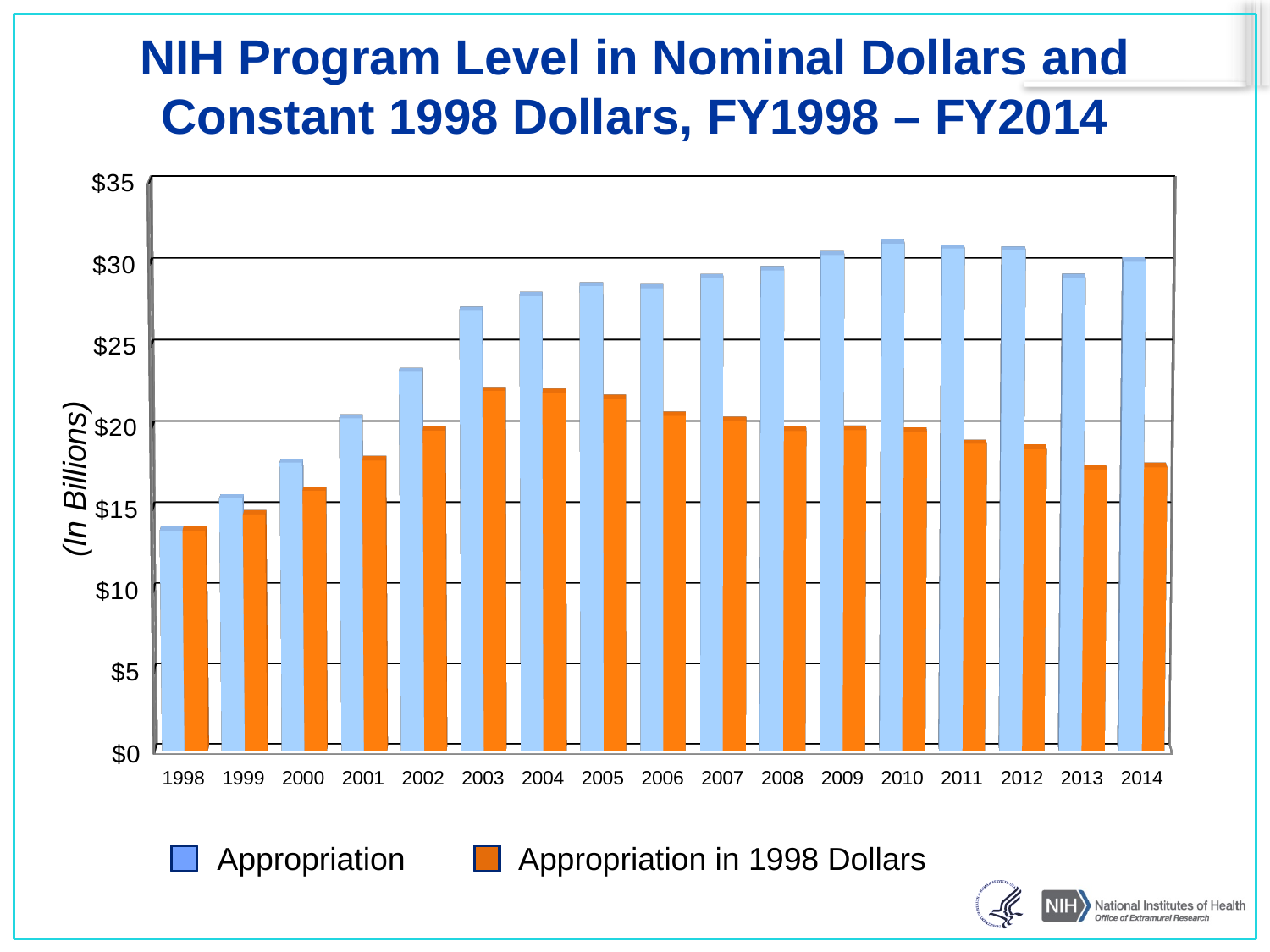
How many fiscal years are shown on the x axis? 17 In which year is the Appropriation (nominal) bar the highest? 2010 Does the Appropriation in 1998 Dollars series rise or fall from 2003 to 2013? fall Is the Appropriation in 1998 Dollars value for 2003 greater or less than $20? greater Is the Appropriation value for 2010 greater or less than $30? greater In which year is the Appropriation (nominal) bar the lowest? 1998 How many series does the legend list? 2 What colour represents the Appropriation in 1998 Dollars series? orange In which year is the Appropriation in 1998 Dollars bar the lowest? 1998 What kind of chart is shown on the slide? bar chart Is the Appropriation in 1998 Dollars value for 2014 greater or less than $20? less Which is larger in 2002: Appropriation or Appropriation in 1998 Dollars? Appropriation